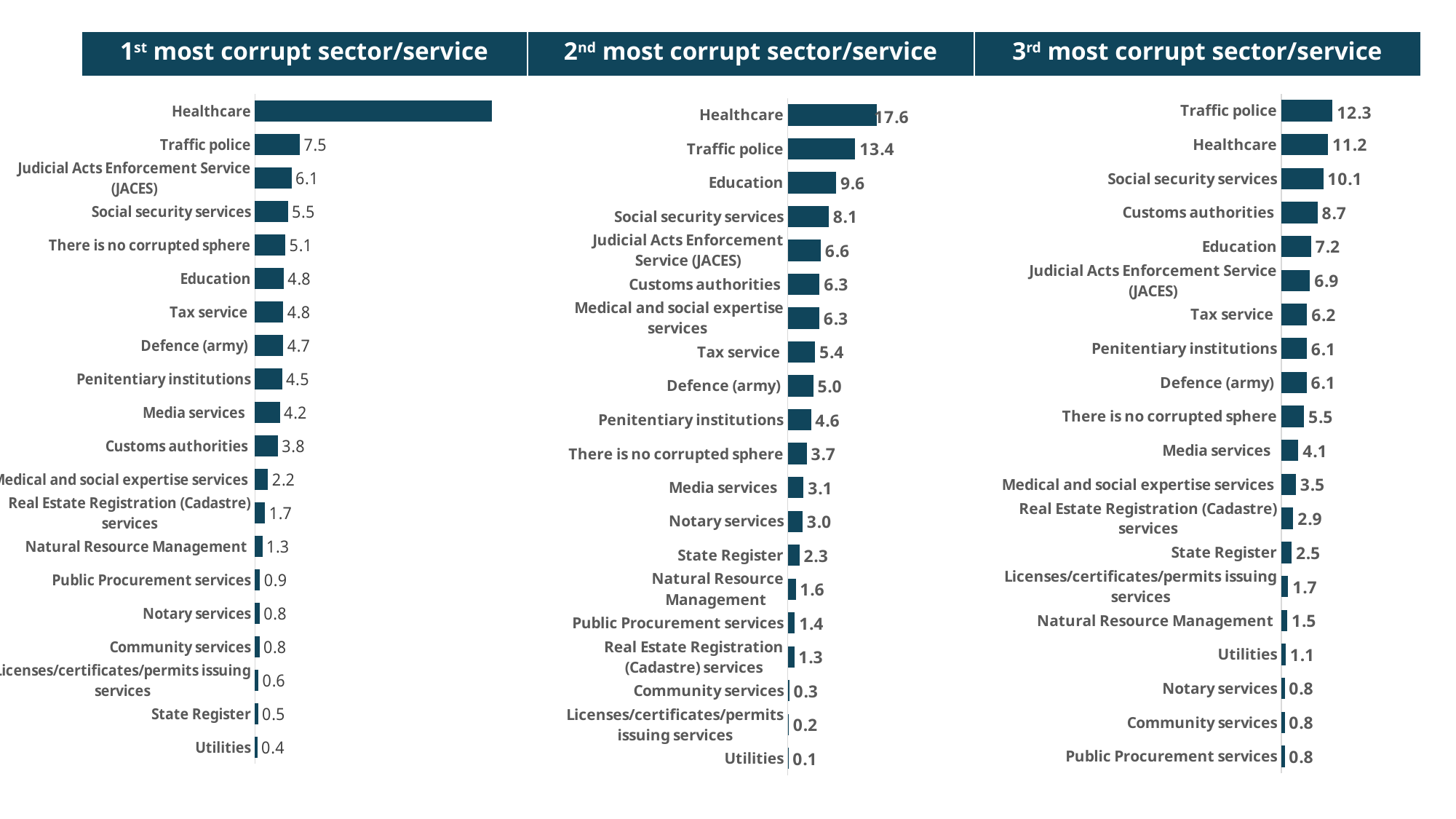
In the '1st most corrupt sector/service' chart, which category has the lowest value? Utilities In the '3rd most corrupt sector/service' chart, what is the value for Customs authorities? 8.7 In the '3rd most corrupt sector/service' chart, which is larger: Social security services or Education? Social security services How many categories are shown in the '2nd most corrupt sector/service' chart? 20 In the '2nd most corrupt sector/service' chart, which category has the highest value? Healthcare In the '1st most corrupt sector/service' chart, what is the difference between Judicial Acts Enforcement Service (JACES) and Social security services? 0.6 In the '2nd most corrupt sector/service' chart, what is the value for Education? 9.6 In the '1st most corrupt sector/service' chart, which category has the longest bar? Healthcare In the '3rd most corrupt sector/service' chart, which category has the highest value? Traffic police In the '2nd most corrupt sector/service' chart, what is the difference between Healthcare and Traffic police? 4.2 What type of chart is the '3rd most corrupt sector/service' chart? Bar chart In the '1st most corrupt sector/service' chart, what is the value for Traffic police? 7.5